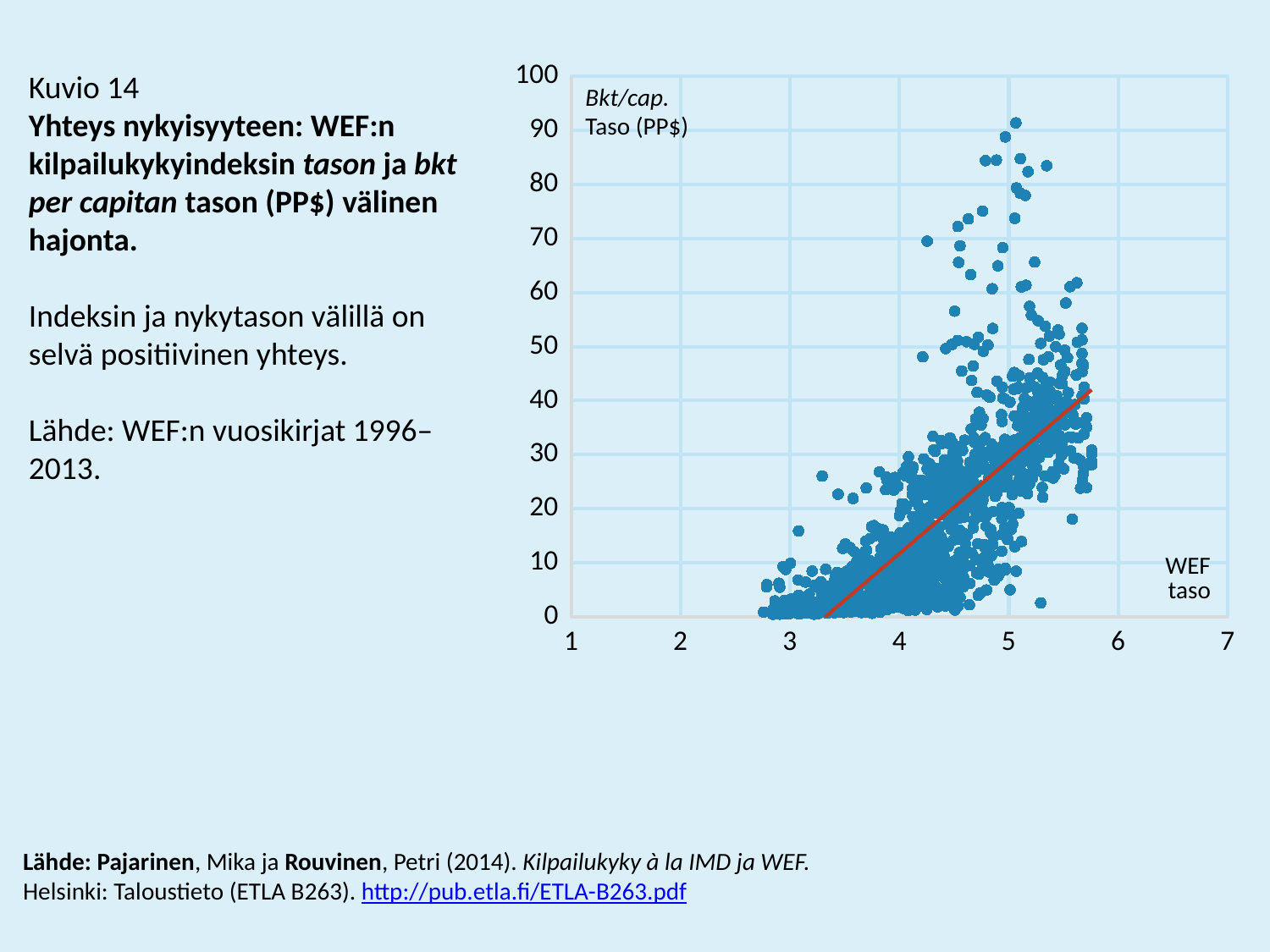
Is the smallest x-axis (WEF taso) value among the plotted points greater or less than 2? greater Are there any plotted points with a WEF level greater than 6? No Is the highest plotted point on the chart greater or less than 80 on the y axis? greater As the WEF level on the x axis increases, do the GDP per capita values generally rise or fall? Rise What kind of chart is shown on the slide? Scatter plot What is the label on the x axis of the chart? WEF taso What colour is the fitted trend line on the chart? Red